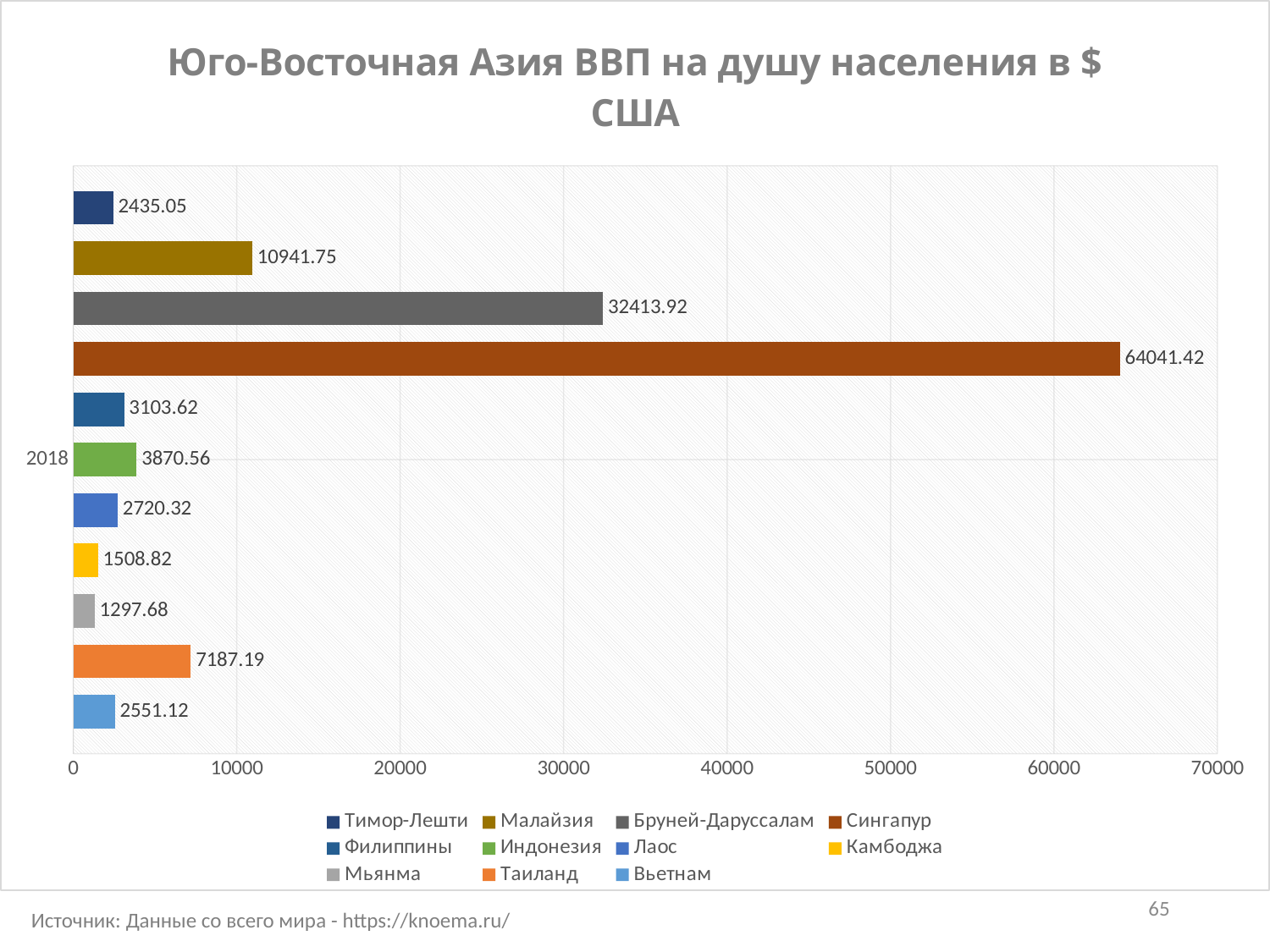
Which country has the highest GDP per capita on the chart? Сингапур Which is larger, the value for Индонезия or the value for Филиппины? Индонезия What kind of chart is shown on the slide? bar chart What is the GDP per capita value shown for Сингапур? 64041.42 Which year is labelled on the vertical axis of the chart? 2018 Which country has the lowest GDP per capita on the chart? Мьянма Is the value for Бруней-Даруссалам greater or less than 30000? greater How many countries (series) does the legend list? 11 What is the value shown for Таиланд? 7187.19 What is the value shown for Малайзия? 10941.75 What is the value shown for Мьянма? 1297.68 What is the difference between the values for Сингапур and Бруней-Даруссалам? 31627.50